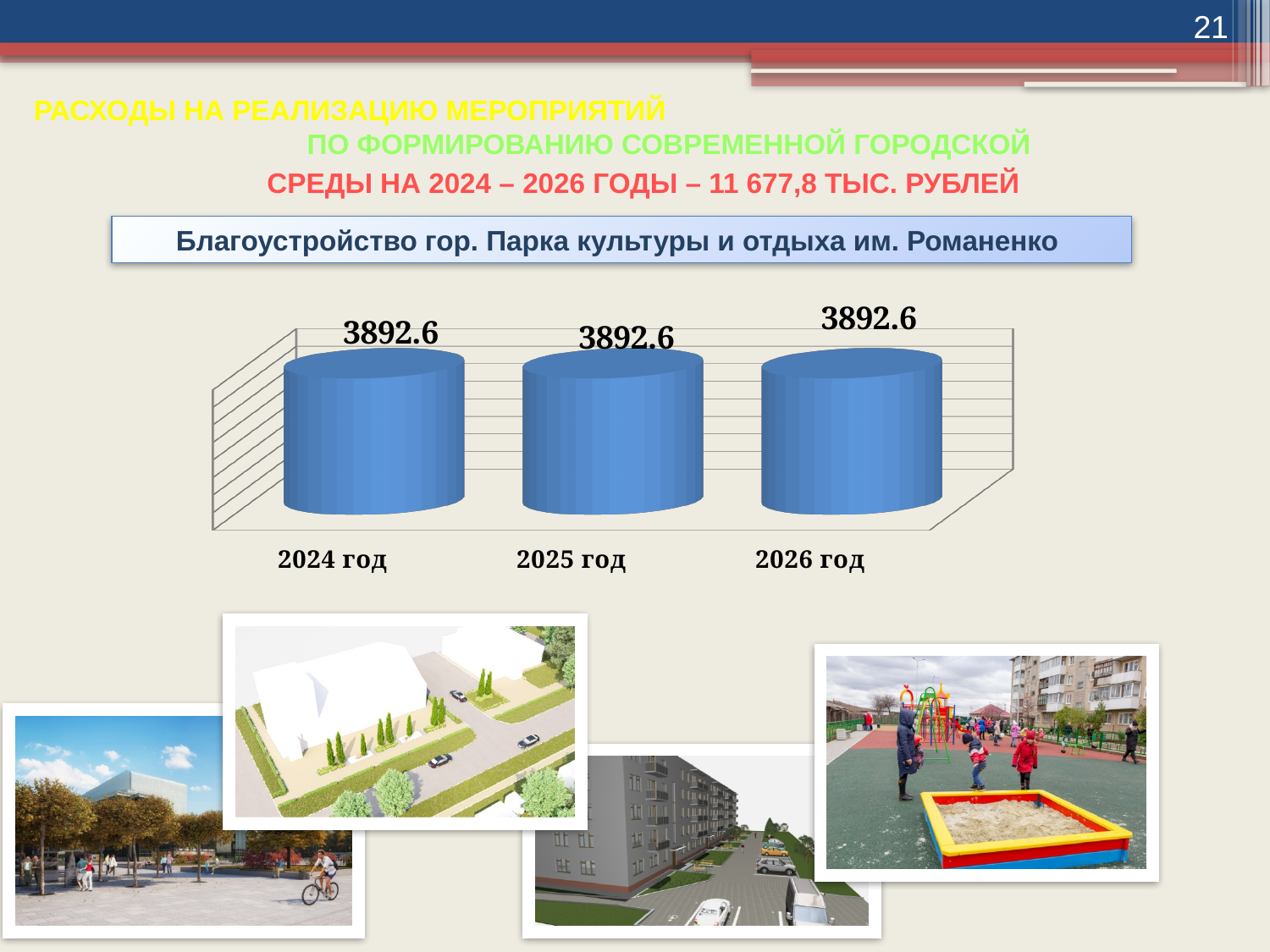
Is the value for 2025 год larger than, smaller than, or equal to the value for 2024 год? equal Which year is the first category on the x axis? 2024 год What is the value for 2024 год? 3892.6 What kind of chart is shown on the slide? bar chart What is the value for 2025 год? 3892.6 Do the values rise, fall, or stay the same from 2024 год to 2026 год? stay the same How many categories (years) are shown on the chart? 3 What is the difference between the values for 2024 год and 2026 год? 0 What is the value for 2026 год? 3892.6 What is the title shown above the chart? Благоустройство гор. Парка культуры и отдыха им. Романенко